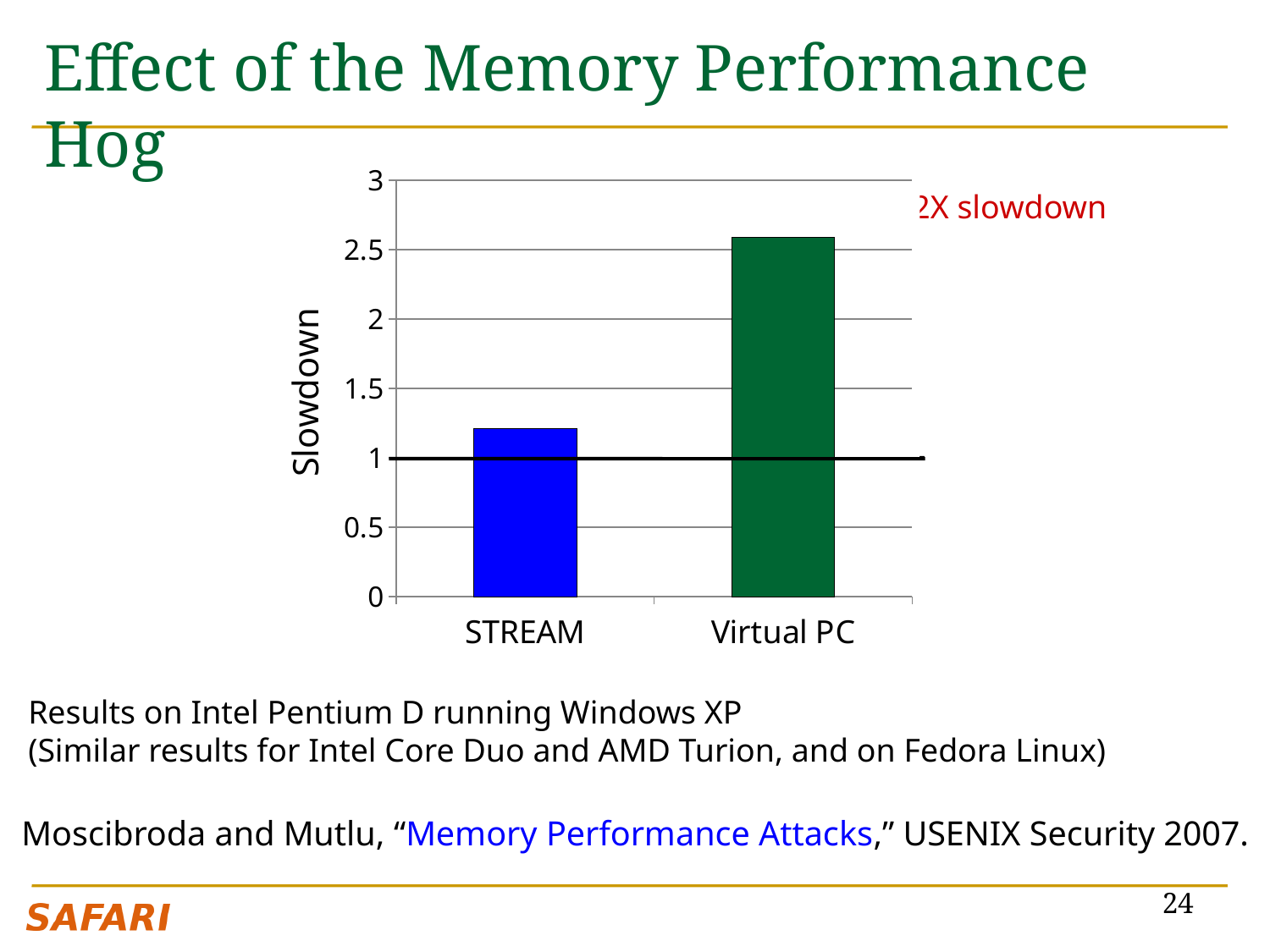
Which has a larger slowdown, STREAM or Virtual PC? Virtual PC What kind of chart is shown on the slide? bar chart Which category has the lowest slowdown in the chart? STREAM Is the slowdown for STREAM greater or less than 1? greater Is the slowdown for STREAM greater or less than 1.5? less What colour is the bar for Virtual PC? green How many categories are plotted on the x axis of the chart? 2 Which category has the highest slowdown in the chart? Virtual PC Is the slowdown for Virtual PC greater or less than 3? less What is the label of the y axis of the chart? Slowdown